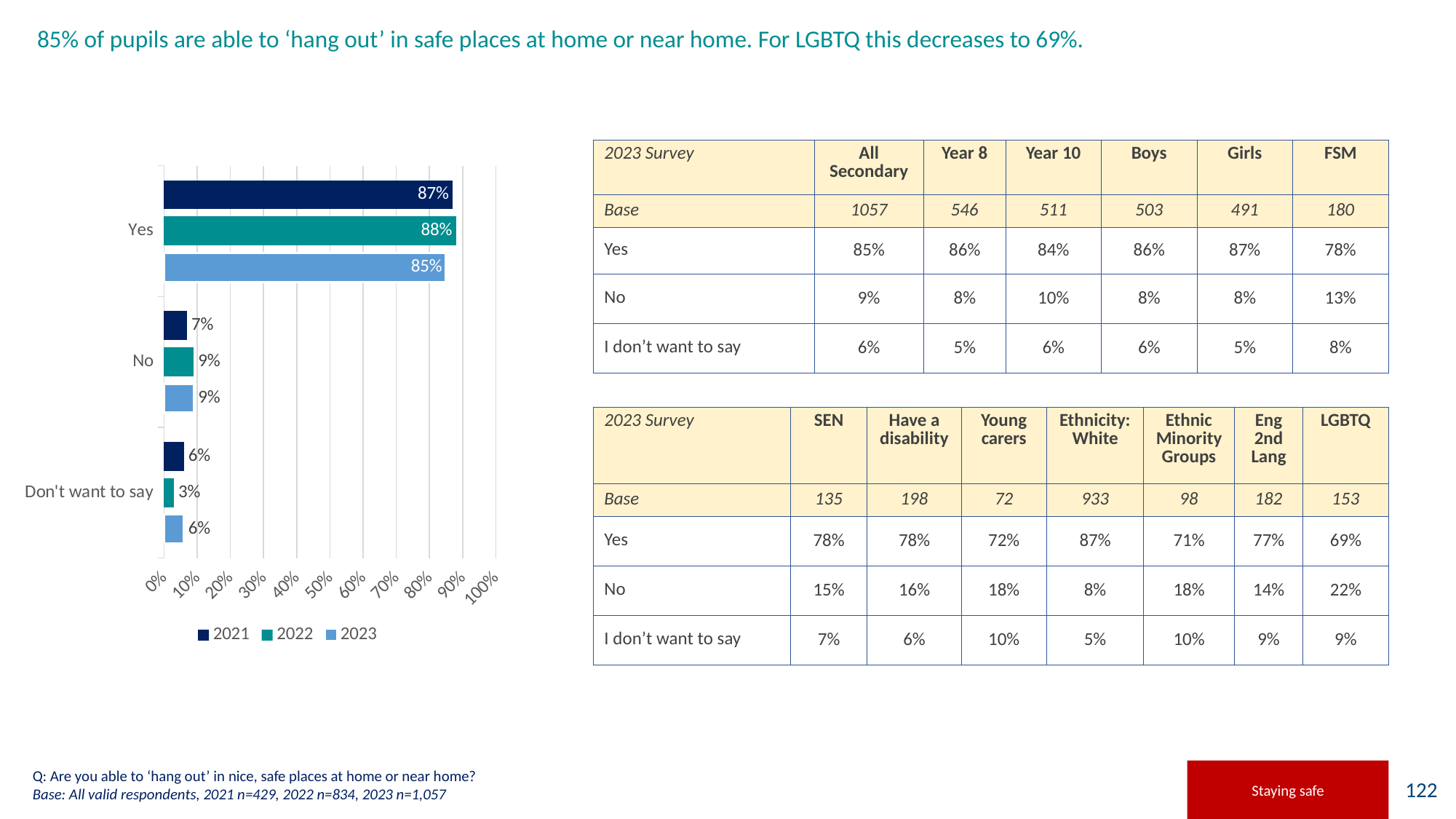
Which years are listed in the chart legend? 2021, 2022, 2023 What kind of chart is shown on the slide? bar chart How many series does the chart legend list? 3 Is the 2021 value for 'Yes' larger or smaller than the 2023 value for 'Yes'? larger Is the 2023 value for 'Yes' greater or less than 80%? greater Which year has the highest value for 'Yes' in the chart? 2022 What is the 2021 value for 'No' in the chart? 7% What is the 2023 value for 'Yes' in the chart? 85% What is the 2022 value for 'Don't want to say' in the chart? 3% What is the difference between the 2022 and 2023 values for 'Yes' in the chart? 3% Which year has the lowest value for 'Don't want to say' in the chart? 2022 How many response categories are shown on the chart? 3